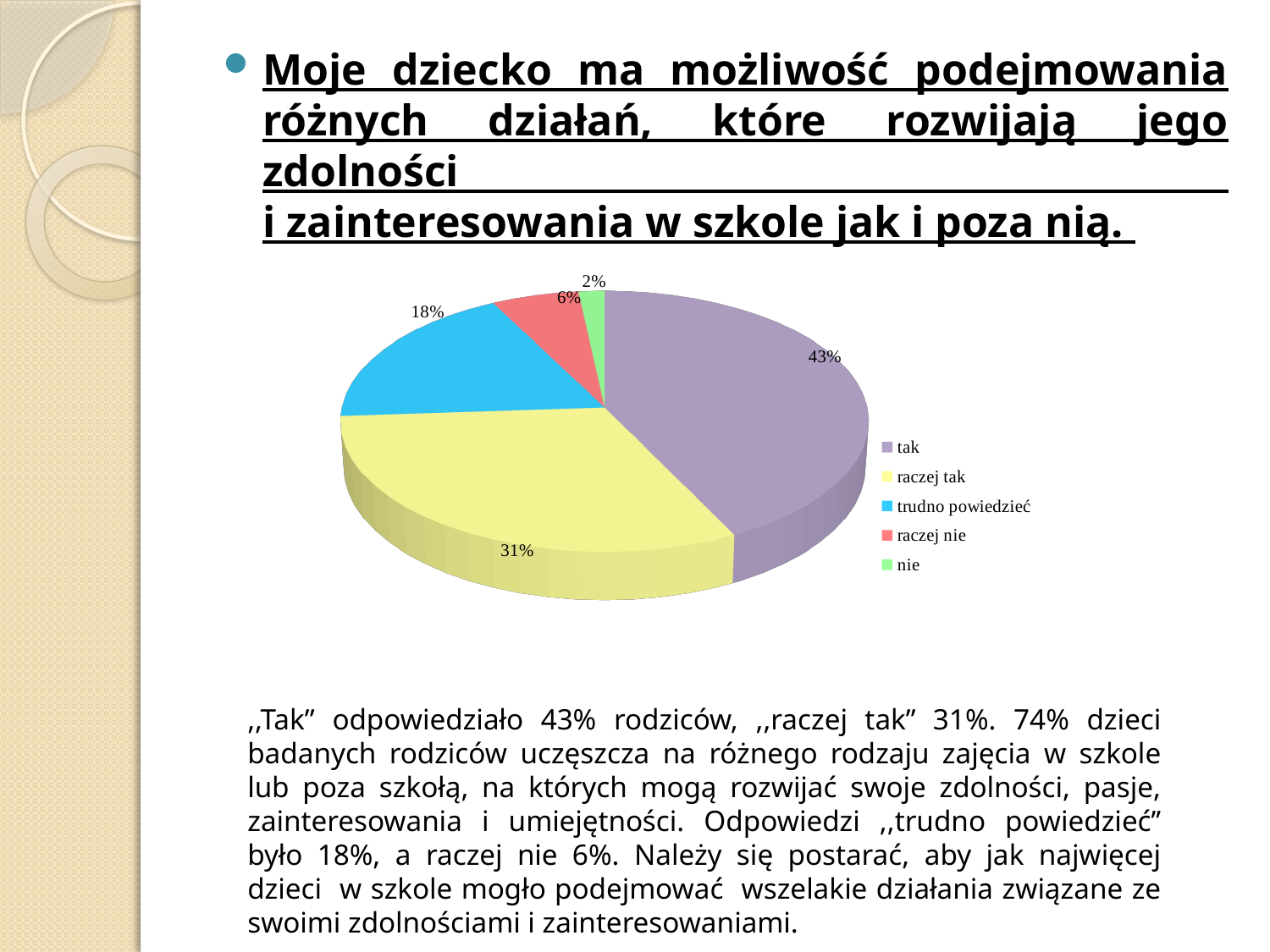
What percentage of the pie chart is the "tak" slice? 43% What percentage of the pie chart is the "raczej nie" slice? 6% What is the difference in percentage points between the "tak" and "raczej tak" slices? 12 What percentage of the pie chart is the "nie" slice? 2% What percentage of the pie chart is the "raczej tak" slice? 31% What percentage of the pie chart is the "trudno powiedzieć" slice? 18% How many categories does the legend of the pie chart list? 5 Which category has the largest slice of the pie chart? tak What colour is the "trudno powiedzieć" slice in the pie chart? blue Which slice is larger, "trudno powiedzieć" or "raczej nie"? trudno powiedzieć What type of chart is shown on the slide? pie chart Which category has the smallest slice of the pie chart? nie